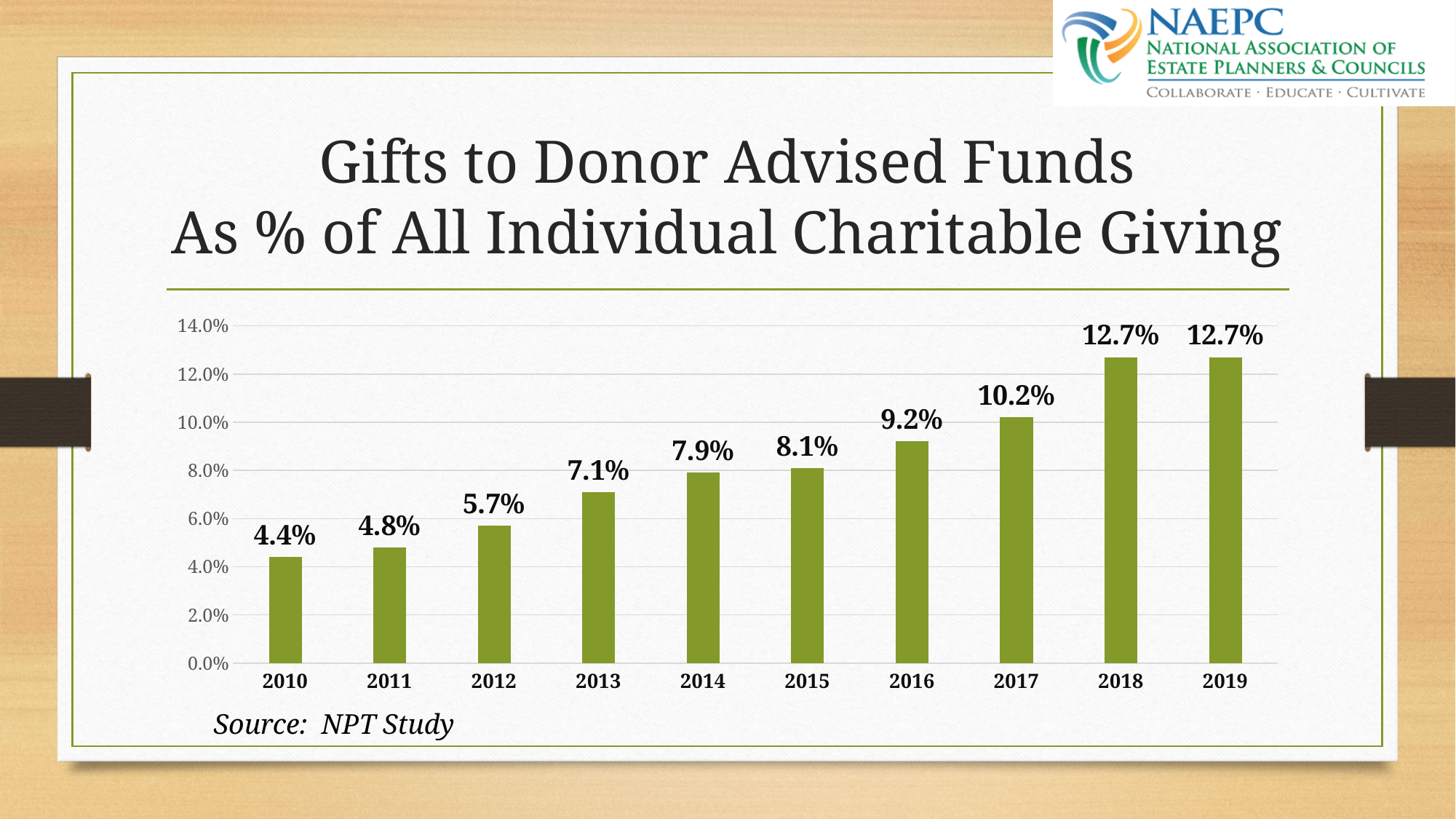
What is the difference between the values for 2016 and 2015? 1.1% Which year has the lowest value? 2010 What source is cited below the chart? NPT Study What is the value for 2013? 7.1% What is the value for 2010? 4.4% Is the value for 2016 greater or less than 8.0%? greater What is the value for 2017? 10.2% Which is larger, the value for 2014 or the value for 2012? 2014 Do the values generally rise or fall from 2010 to 2019? rise What kind of chart is shown on the slide? bar chart What is the difference between the values for 2019 and 2010? 8.3% How many years are shown on the x axis? 10